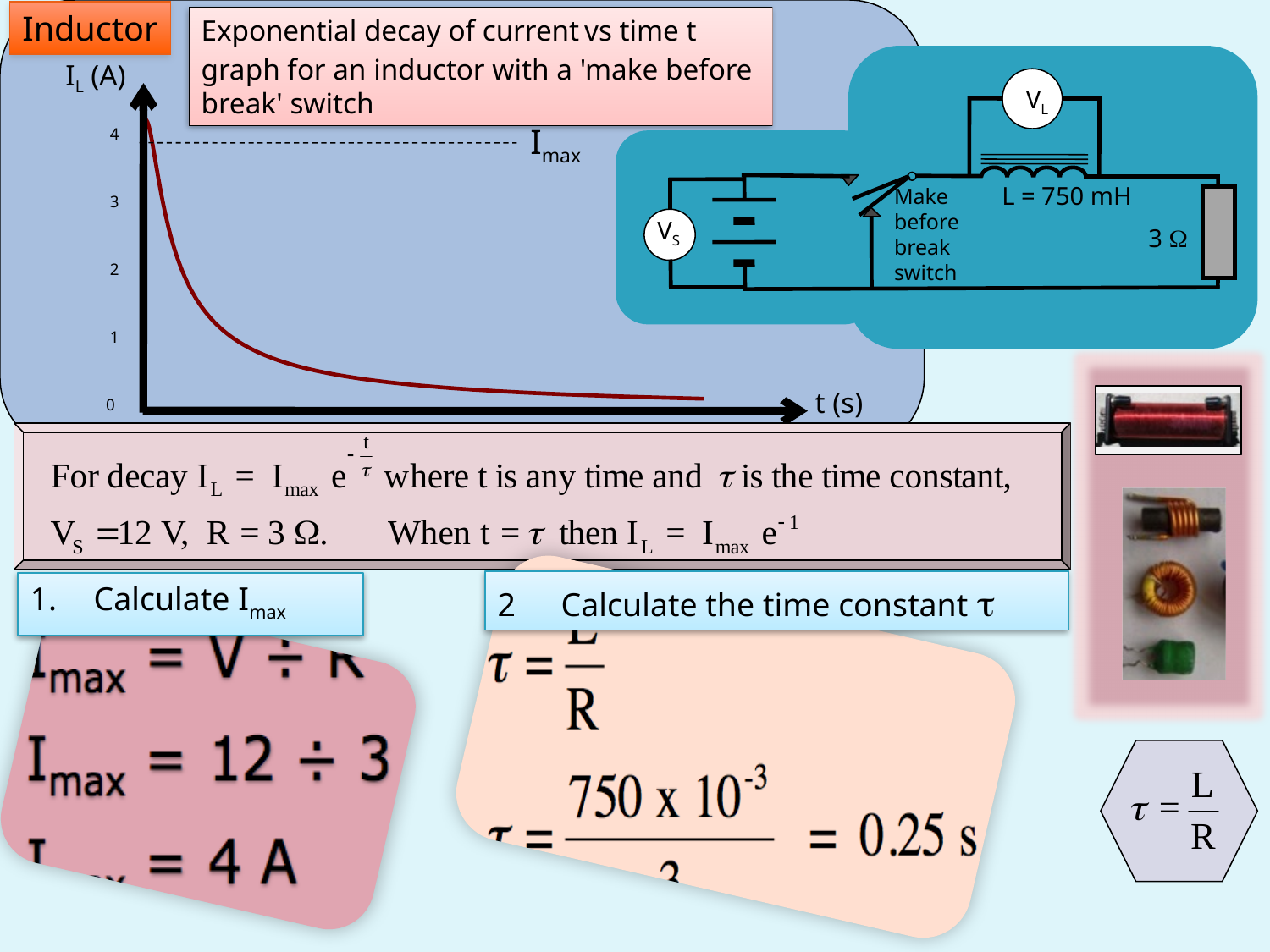
What value on the vertical axis does the dashed I_max line correspond to? 4 According to the slide, what is the calculated value of I_max? 4 A What is the highest value shown on the vertical axis scale? 4 What is the label on the vertical axis of the graph? I_L (A) Is the current at the right-hand end of the curve greater or less than 1? less Does the current I_L rise or fall as time t increases along the x axis? fall What is the label on the horizontal axis of the graph? t (s) Is the current at the start of the curve (t = 0) greater or less than 3? greater What is the lowest value shown on the vertical axis scale? 0 How many curves are plotted on the graph? 1 What kind of chart is shown on the slide? line chart How many numbered tick marks are shown on the vertical axis? 5